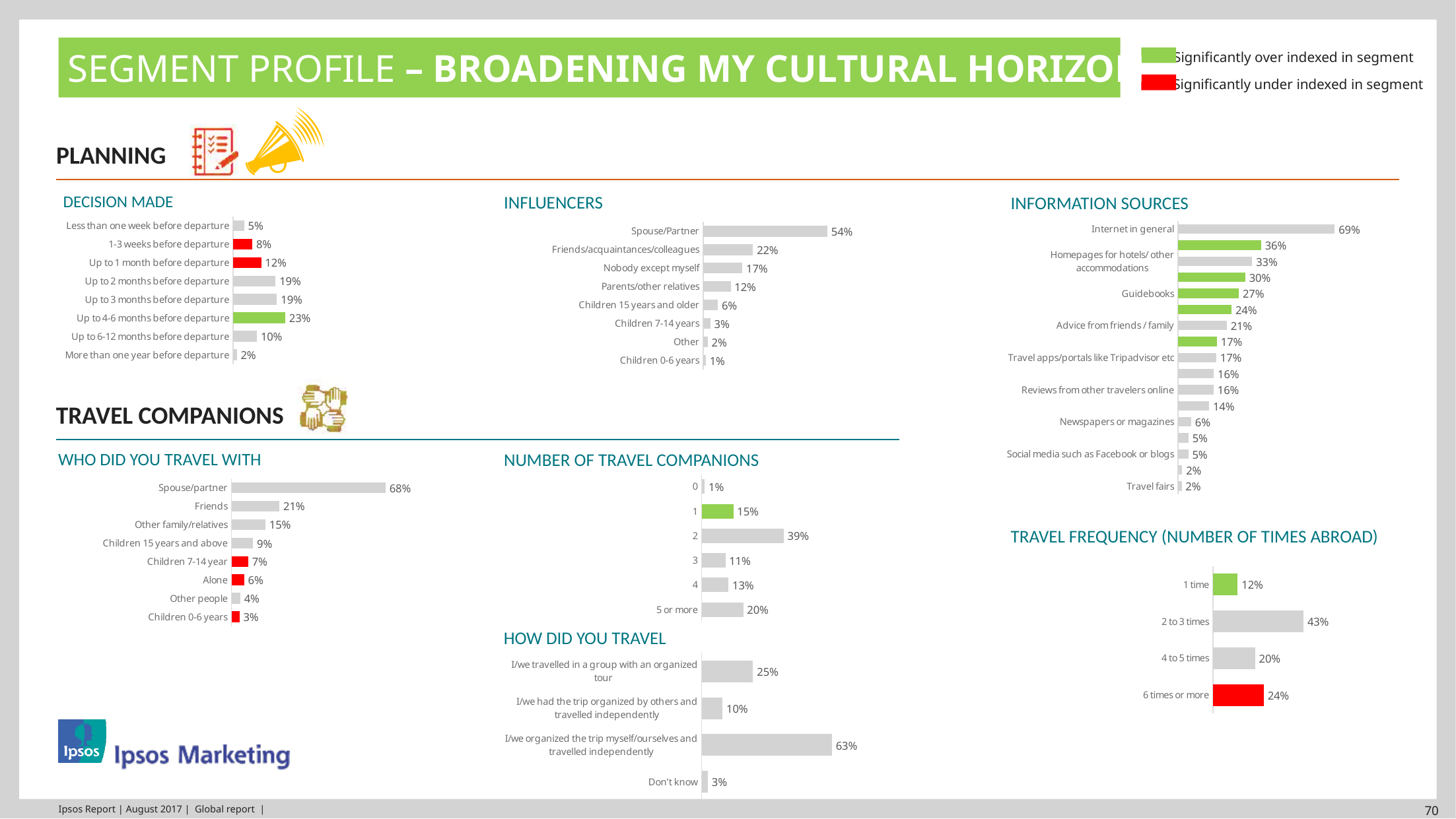
In the How Did You Travel chart, what is the value for 'I/we organized the trip myself/ourselves and travelled independently'? 63% In the Number of Travel Companions chart, which category has the highest value? 2 In the Influencers chart, how many categories are shown? 8 In the Travel Frequency (Number of Times Abroad) chart, what is the difference between 2 to 3 times and 6 times or more? 19% In the Information Sources chart, what is the value for Guidebooks? 27% In the Influencers chart, what is the difference between Friends/acquaintances/colleagues and Nobody except myself? 5% In the Influencers chart, what is the value for Spouse/Partner? 54% In the Decision Made chart, which category has the lowest value? More than one year before departure In the Who Did You Travel With chart, which is larger, Friends or Other family/relatives? Friends In the Information Sources chart, which category has the highest value? Internet in general In the Decision Made chart, what is the value for Up to 4-6 months before departure? 23% What type of chart is the Travel Frequency (Number of Times Abroad) chart? Bar chart